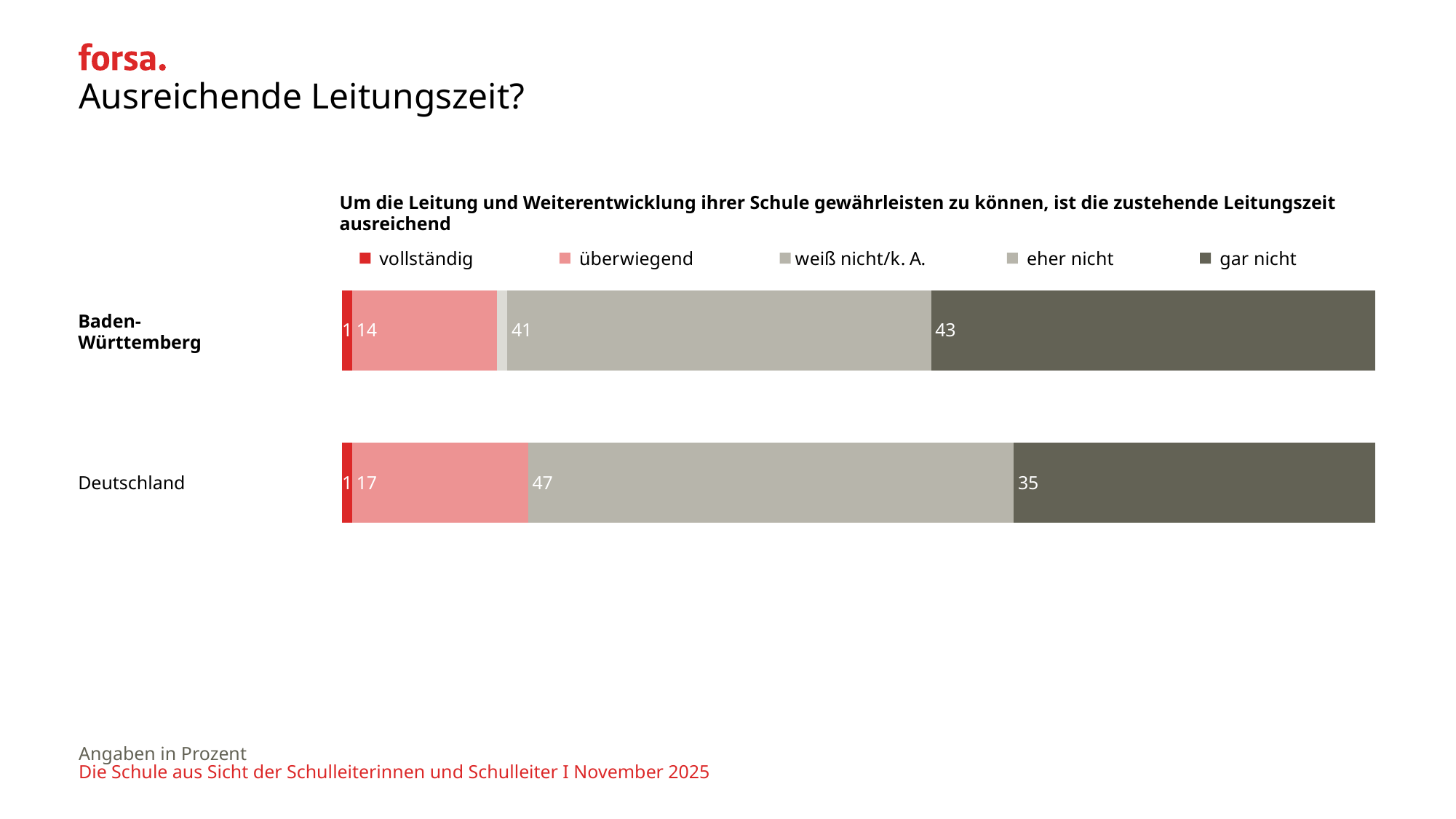
What kind of chart is shown on the slide? Stacked bar chart What is the value for "eher nicht" for Deutschland? 47 What is the difference between the "gar nicht" values for Baden-Württemberg and Deutschland? 8 Which response category has the highest value for Deutschland? eher nicht Which has the larger "gar nicht" value, Baden-Württemberg or Deutschland? Baden-Württemberg How many categories (rows) are shown in the chart? 2 What is the value for "überwiegend" for Baden-Württemberg? 14 What is the difference between the "eher nicht" values for Deutschland and Baden-Württemberg? 6 How many series does the legend list? 5 Which has the larger "überwiegend" value, Baden-Württemberg or Deutschland? Deutschland What is the value for "gar nicht" for Baden-Württemberg? 43 What is the value for "vollständig" for Deutschland? 1